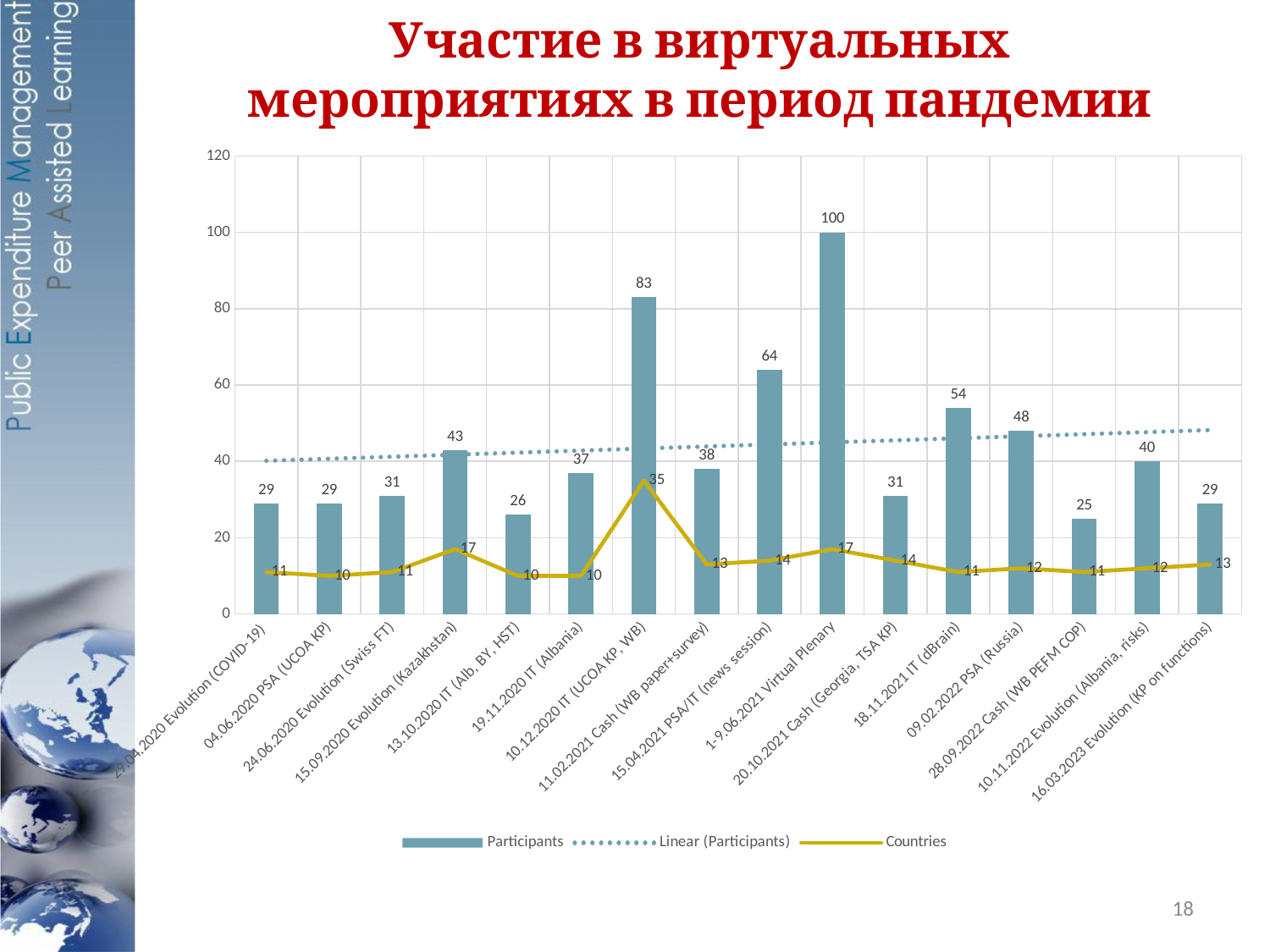
Which has more Participants: 18.11.2021 IT (dBrain) or 09.02.2022 PSA (Russia)? 18.11.2021 IT (dBrain) How many Participants are shown for 1-9.06.2021 Virtual Plenary? 100 What is the Countries value for 16.03.2023 Evolution (KP on functions)? 13 What is the difference in Participants between 10.12.2020 IT (UCOA KP, WB) and 15.04.2021 PSA/IT (news session)? 19 What is the Countries value for 10.12.2020 IT (UCOA KP, WB)? 35 Is the Participants value for 11.02.2021 Cash (WB paper+survey) greater or less than 40? less What type of chart is used for the Participants series? bar chart Which event has the lowest number of Participants? 28.09.2022 Cash (WB PEFM COP) How many entries does the legend list? 3 Which event has the highest number of Participants? 1-9.06.2021 Virtual Plenary How many Participants are shown for 15.09.2020 Evolution (Kazakhstan)? 43 How many events (categories) are shown on the x axis? 16